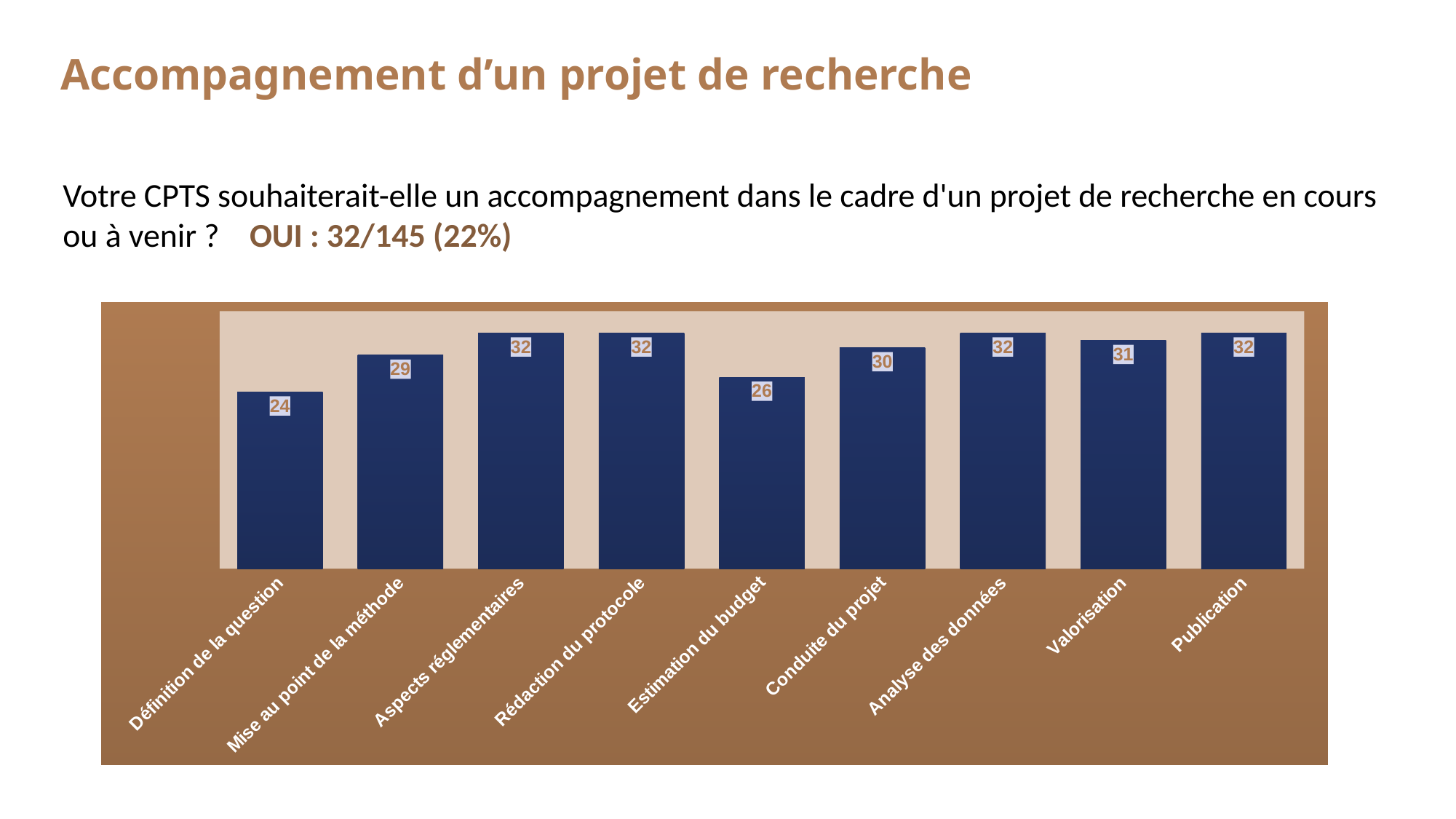
What is the value for Mise au point de la méthode? 29 Which is larger, the value for Mise au point de la méthode or the value for Estimation du budget? Mise au point de la méthode Which category has the lowest value? Définition de la question What is the value for Publication? 32 How many categories are shown in the chart? 9 What is the value for Valorisation? 31 What kind of chart is shown on the slide? Bar chart What is the difference between the values for Rédaction du protocole and Estimation du budget? 6 What is the value for Définition de la question? 24 What is the value for Conduite du projet? 30 What is the value for Estimation du budget? 26 What is the difference between the values for Conduite du projet and Définition de la question? 6